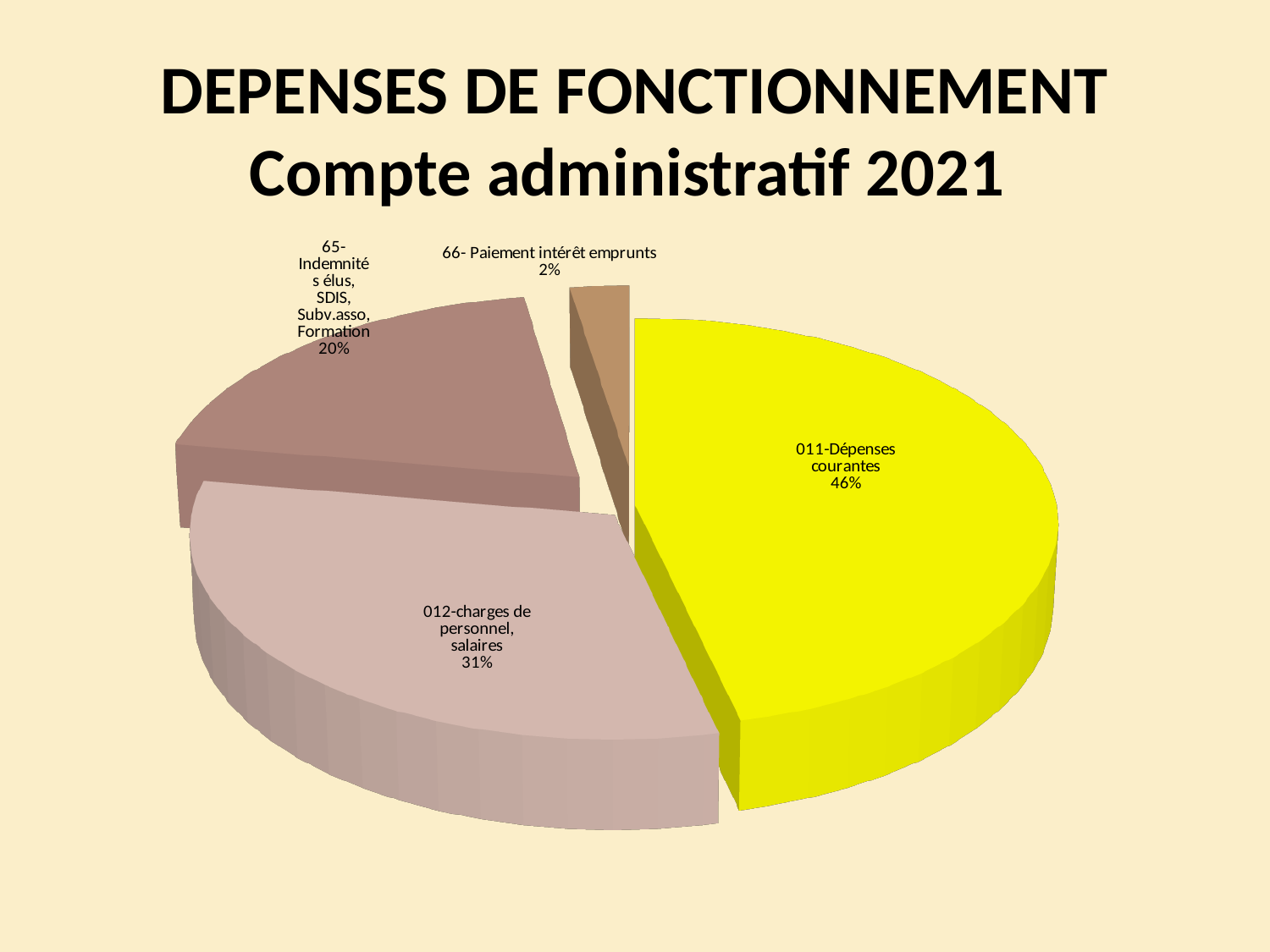
What share of the pie does '011-Dépenses courantes' represent? 46% What is the title shown above the chart? DEPENSES DE FONCTIONNEMENT Compte administratif 2021 Which category has the smallest share of the pie? 66- Paiement intérêt emprunts What share of the pie does '65-Indemnités élus, SDIS, Subv.asso, Formation' represent? 20% What is the difference in percentage points between '011-Dépenses courantes' and '012-charges de personnel, salaires'? 15 How many slices does the pie chart have? 4 What share of the pie does '012-charges de personnel, salaires' represent? 31% Which category has the largest share of the pie? 011-Dépenses courantes What is the difference in percentage points between '65-Indemnités élus, SDIS, Subv.asso, Formation' and '66- Paiement intérêt emprunts'? 18 What kind of chart is shown on the slide? pie chart Which is larger: the share for '012-charges de personnel, salaires' or the share for '65-Indemnités élus, SDIS, Subv.asso, Formation'? 012-charges de personnel, salaires